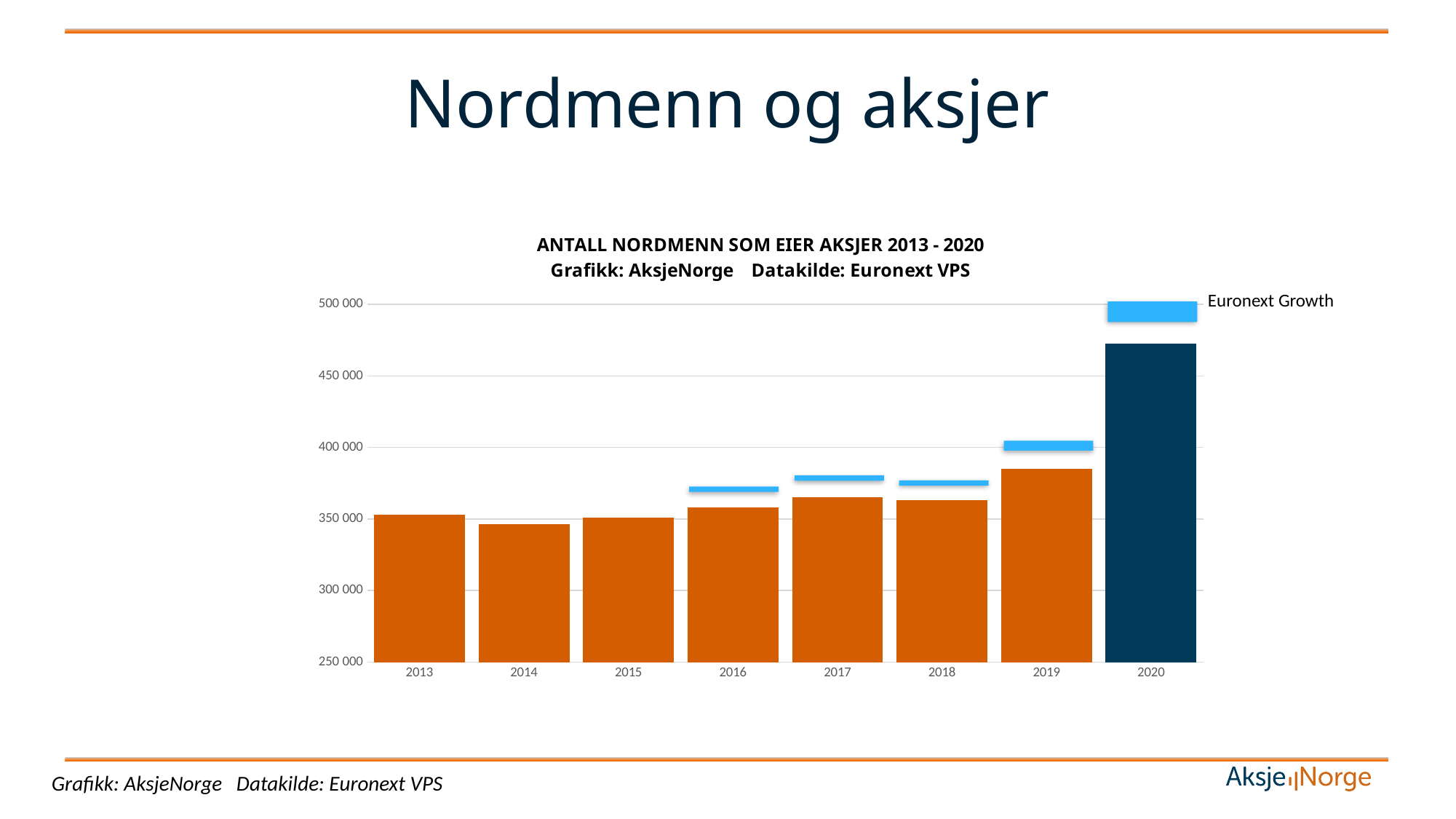
Which year has the lowest number of Norwegians owning shares? 2014 Is the value for 2017 greater or less than 350 000? greater Is the value for 2014 greater or less than 350 000? less Which year has a larger value, 2018 or 2019? 2019 Is the value for 2019 greater or less than 400 000? less What is the title of the chart? ANTALL NORDMENN SOM EIER AKSJER 2013 - 2020 Which year has the highest number of Norwegians owning shares? 2020 What kind of chart is shown on the slide? Bar chart Do the values generally rise or fall from 2013 to 2020? Rise Which year has a larger value, 2016 or 2017? 2017 How many years are shown on the x axis of the chart? 8